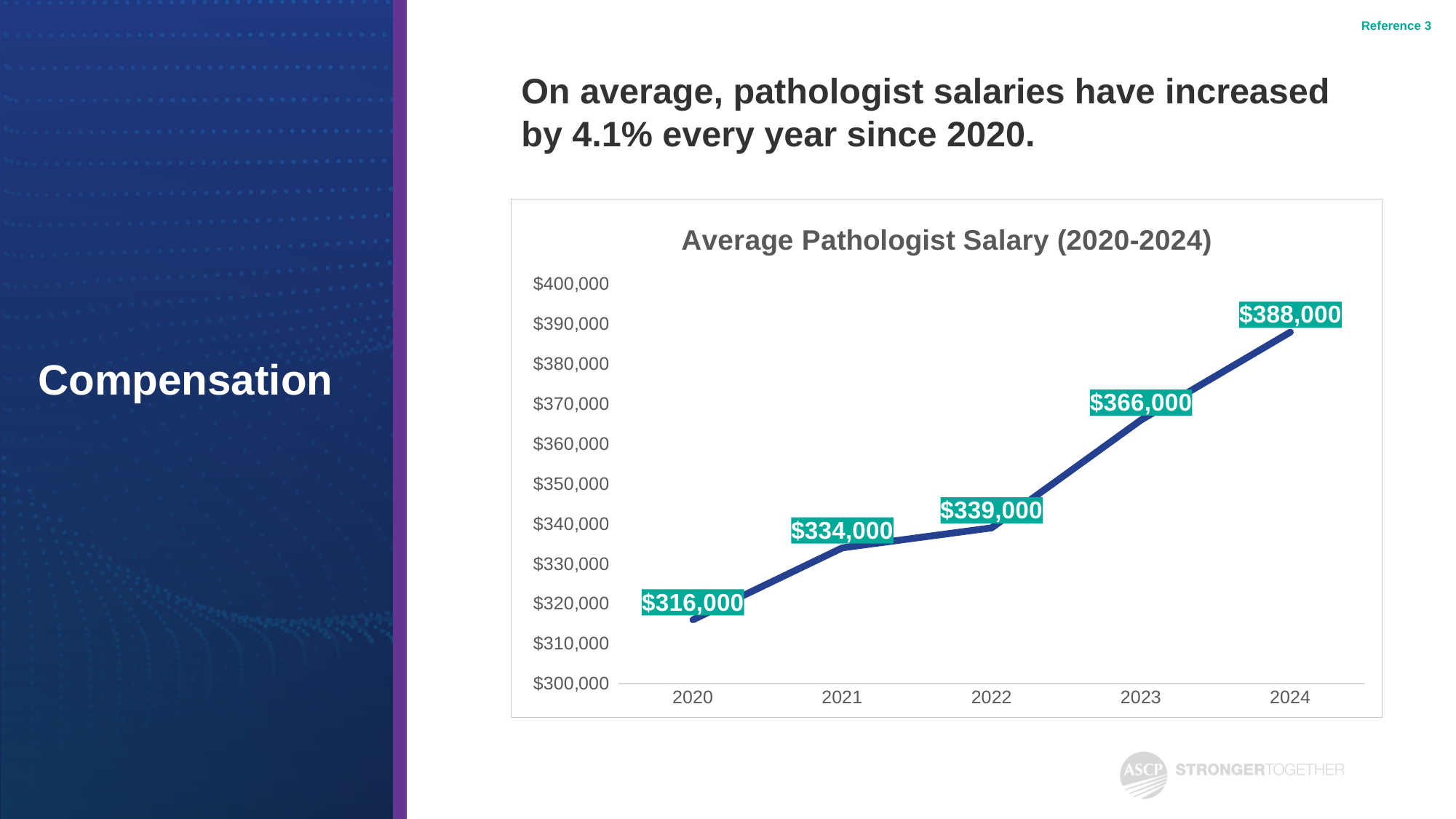
Which year has the lowest average pathologist salary? 2020 What is the difference between the average salary in 2023 and in 2022? $27,000 What is the average pathologist salary shown for 2022? $339,000 What is the average pathologist salary shown for 2024? $388,000 Is the average salary for 2023 greater or less than $360,000? greater Which year has a higher average salary, 2021 or 2023? 2023 Do the average salaries rise or fall from 2020 to 2024? Rise What kind of chart is shown on the slide? Line chart Which year has the highest average pathologist salary? 2024 How many years are plotted on the chart? 5 What is the average pathologist salary shown for 2020? $316,000 What is the difference between the average salary in 2024 and in 2020? $72,000